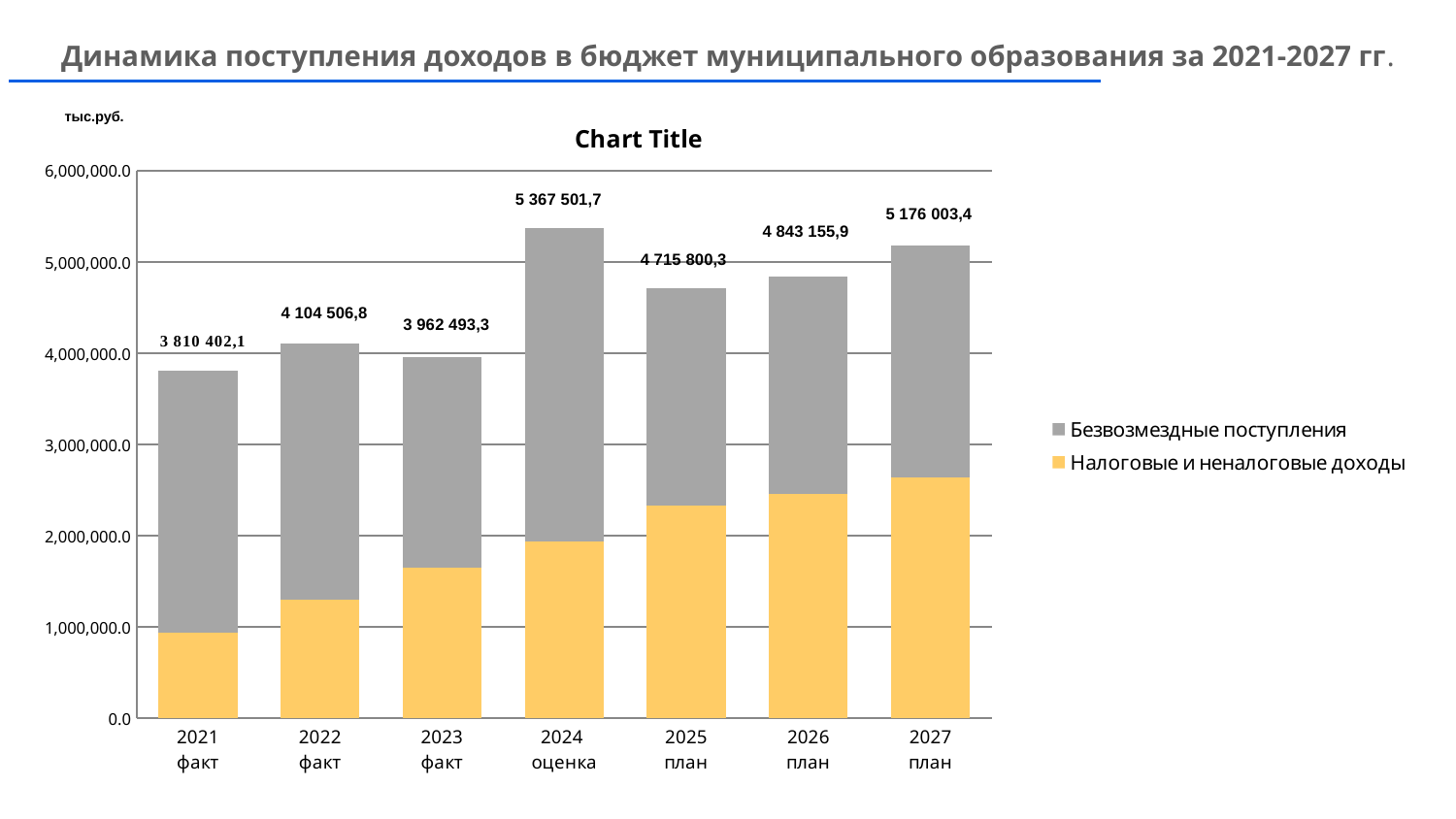
What is the total value labelled above the bar for 2024 оценка? 5 367 501,7 Is the value of Налоговые и неналоговые доходы for 2027 план greater or less than 2,000,000.0? greater What kind of chart is shown on the slide? Stacked bar chart Which series is shown in gray in the legend? Безвозмездные поступления How many bars (years) are plotted on the chart? 7 Which year has the highest total value? 2024 оценка Do the Налоговые и неналоговые доходы values rise or fall from 2021 to 2027? rise What is the total value labelled above the bar for 2021 факт? 3 810 402,1 Which year has the lowest total value? 2021 факт What is the difference between the total for 2027 план and the total for 2026 план? 332 847,5 Which total is larger, 2022 факт or 2023 факт? 2022 факт How many series does the legend list? 2